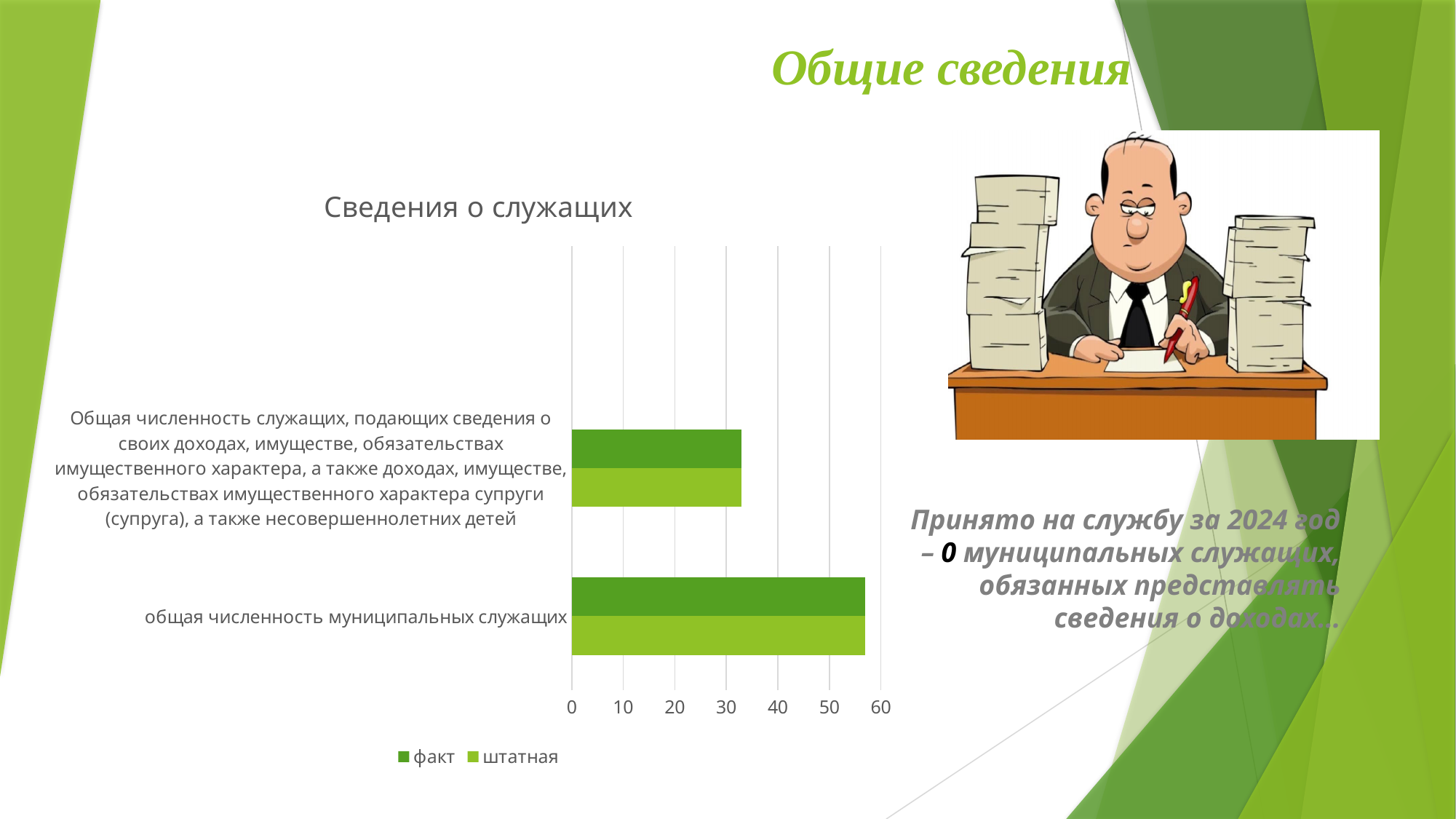
Is the "штатная" value for "Общая численность служащих, подающих сведения о своих доходах..." greater or less than 40? less What are the two series named in the chart legend? факт, штатная Is the "факт" value for "общая численность муниципальных служащих" greater or less than 50? greater Is the "штатная" value for "общая численность муниципальных служащих" greater or less than 60? less What is the title of the chart on the slide? Сведения о служащих How many series does the chart legend list? 2 What kind of chart is shown under the title "Сведения о служащих"? bar chart Which category has the longer bars: "общая численность муниципальных служащих" or "Общая численность служащих, подающих сведения о своих доходах..."? общая численность муниципальных служащих What is the maximum value shown on the chart's horizontal axis? 60 How many categories are shown on the chart's vertical axis? 2